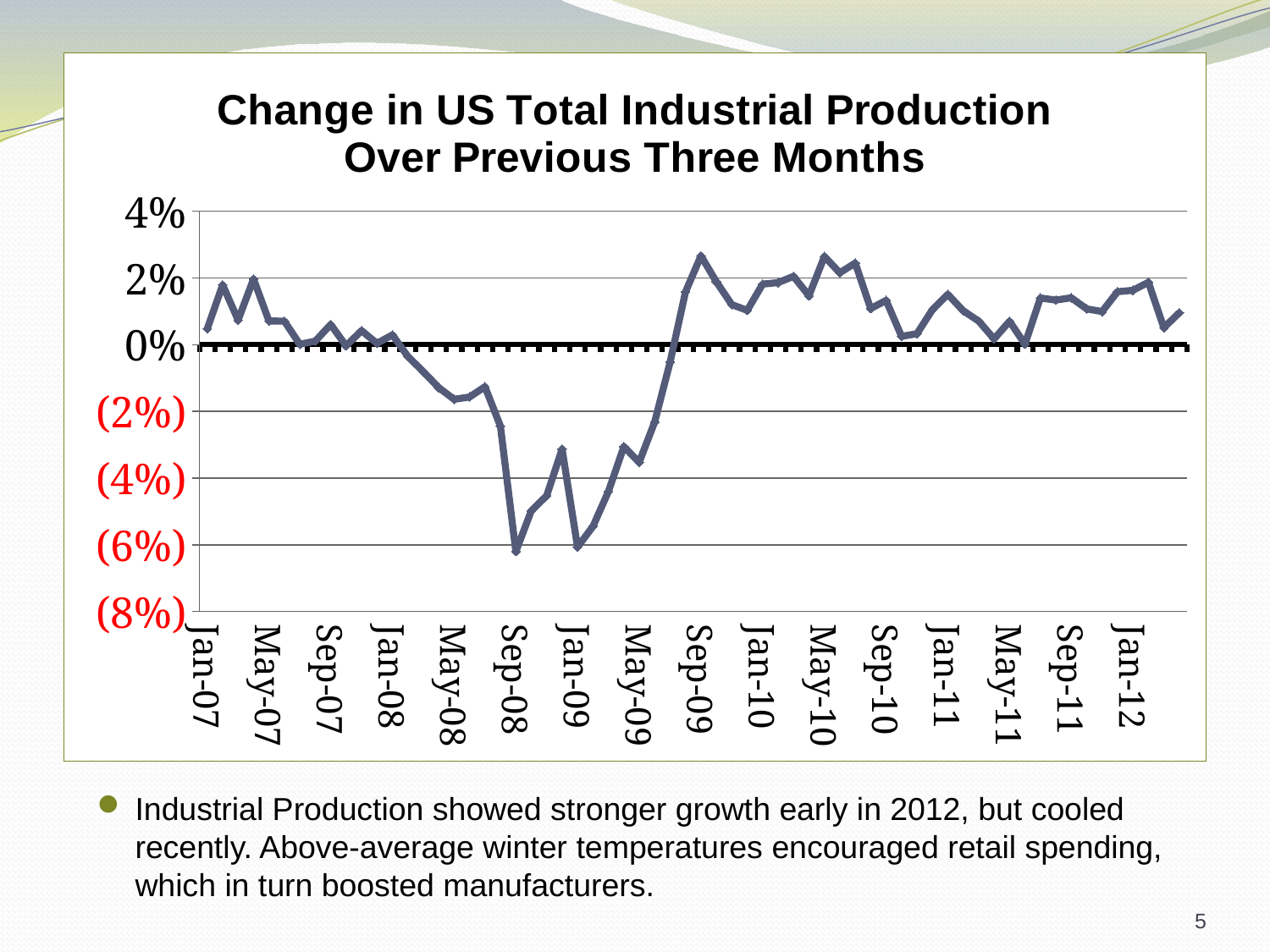
Is the value for May-10 greater or less than 2%? greater Is the value for Jan-09 greater or less than (4%)? less Which has the larger value, Jan-09 or Sep-09? Sep-09 Is the value for May-08 greater or less than 0%? less What is the title of the chart? Change in US Total Industrial Production Over Previous Three Months What is the lowest value labelled on the y axis? (8%) Do the values rise or fall between May-08 and Sep-08? fall Do the values rise or fall between Jan-09 and Sep-09? rise What kind of chart is shown on the slide? line chart How many month labels are shown on the x axis? 16